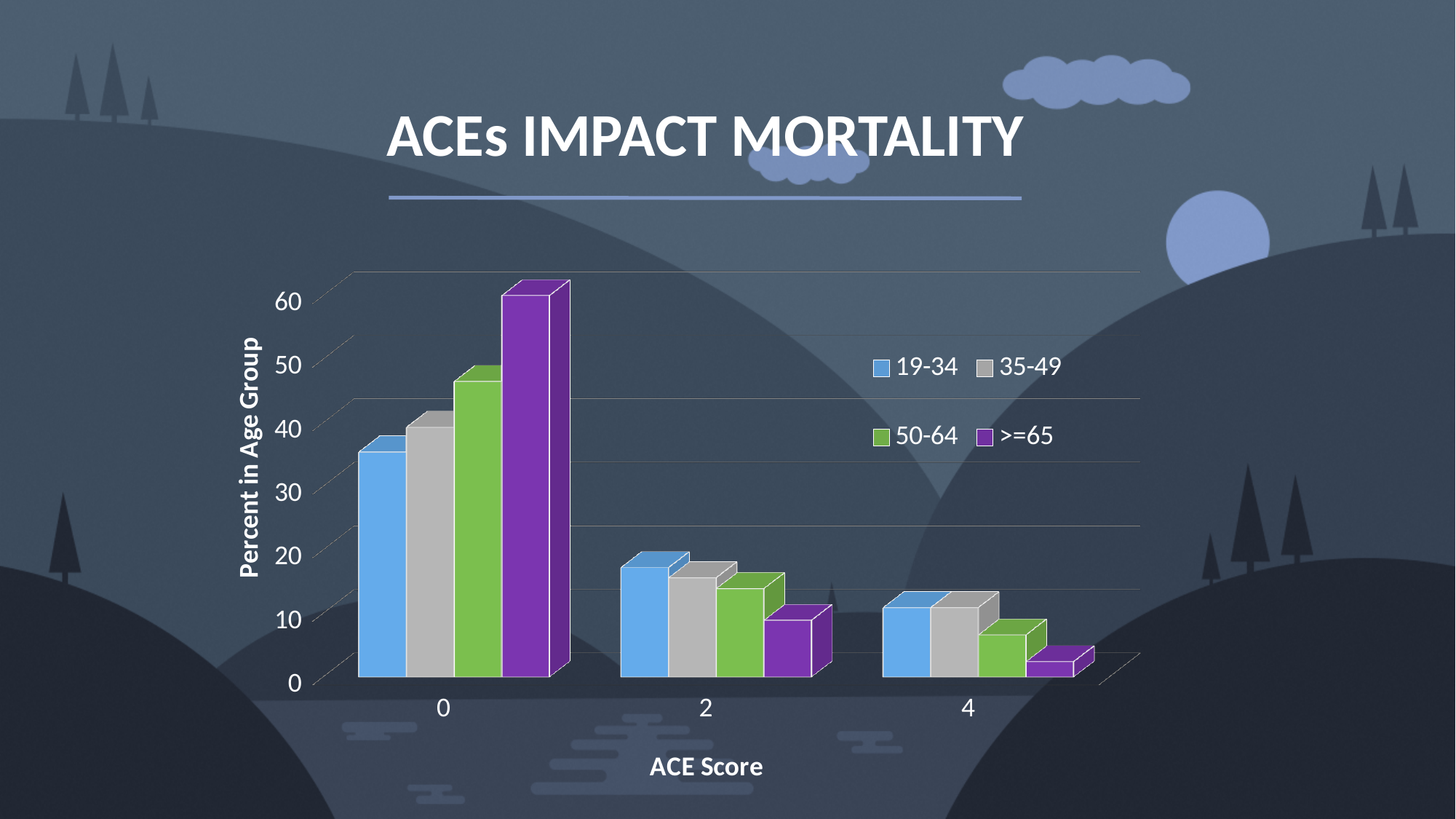
What is the title of the chart? ACEs IMPACT MORTALITY What kind of chart is shown on the slide? bar chart For which ACE Score is the >=65 bar the highest? 0 Do the values for the >=65 group rise or fall as the ACE Score increases from 0 to 4? fall For which ACE Score is the >=65 bar the lowest? 4 At ACE Score 2, which is larger: the 19-34 bar or the >=65 bar? 19-34 What is the label of the vertical axis? Percent in Age Group At ACE Score 0, which is larger: the >=65 bar or the 19-34 bar? >=65 How many series does the legend list? 4 Is the value for the >=65 group at ACE Score 0 greater or less than 50? greater How many ACE Score categories are shown on the x axis? 3 Is the value for the 19-34 group at ACE Score 4 greater or less than 20? less